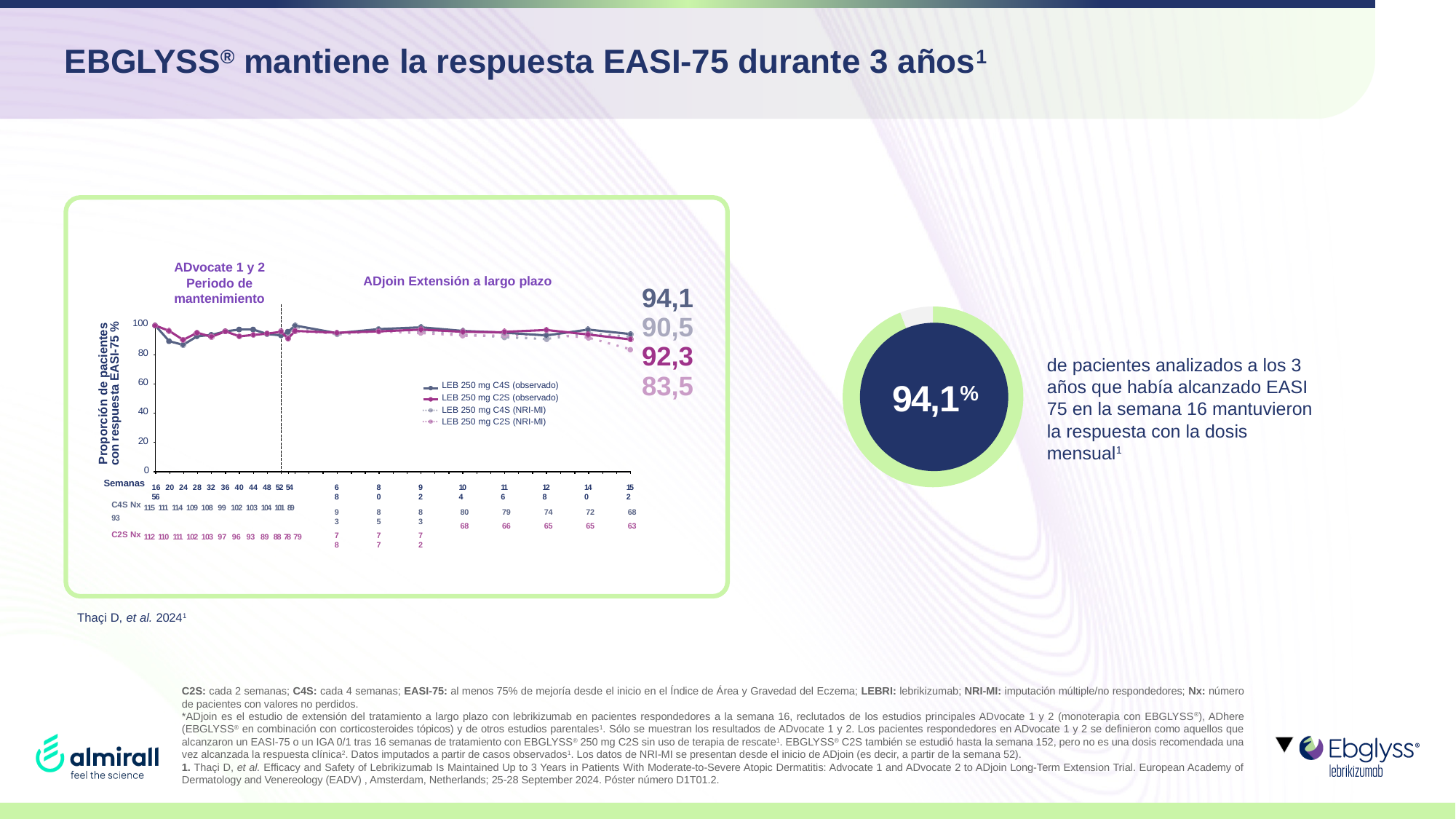
In the line chart, is the final value for LEB 250 mg C2S (NRI-MI) greater or less than 80? greater In the line chart, what is the value printed at the end of the LEB 250 mg C4S (observado) series? 94,1 In the line chart, what is the difference between the final values of LEB 250 mg C4S (observado) and LEB 250 mg C2S (NRI-MI)? 10,6 How many series does the legend of the line chart list? 4 What kind of chart is the chart on the left of the slide? line chart What is the label of the y axis of the line chart? Proporción de pacientes con respuesta EASI-75 % In the line chart, what is the value printed at the end of the LEB 250 mg C2S (observado) series? 92,3 In the line chart, what is the value printed at the end of the LEB 250 mg C2S (NRI-MI) series? 83,5 In the line chart, which series has the highest value printed at the end of the lines? LEB 250 mg C4S (observado) In the line chart, which series has the lowest value printed at the end of the lines? LEB 250 mg C2S (NRI-MI) In the line chart, which final value is larger: LEB 250 mg C2S (observado) or LEB 250 mg C4S (NRI-MI)? LEB 250 mg C2S (observado) What percentage is shown in the centre of the donut chart on the right of the slide? 94,1%